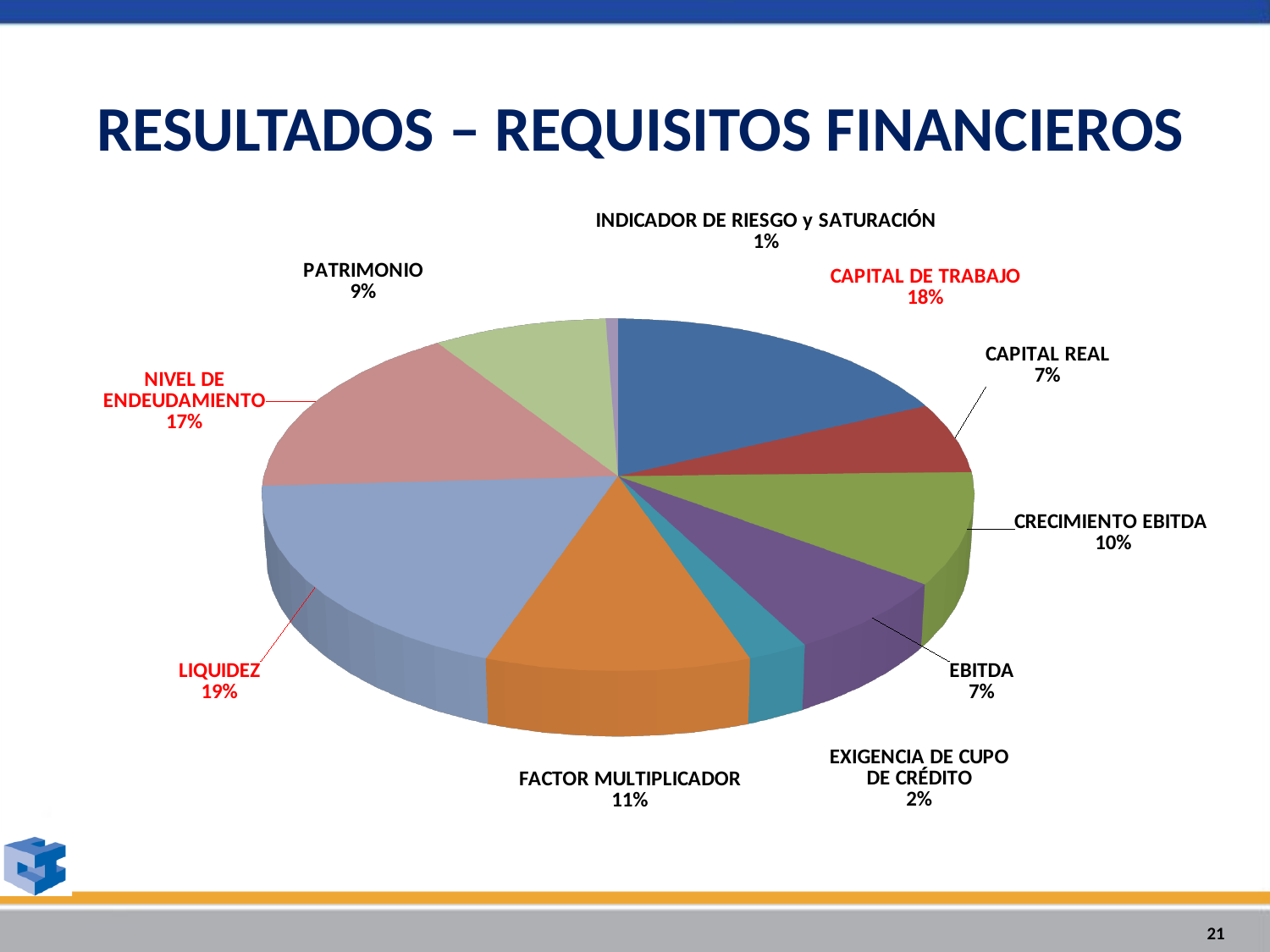
What is the value shown for CAPITAL DE TRABAJO? 18% What is the title of the slide containing the chart? RESULTADOS – REQUISITOS FINANCIEROS What is the combined share of CAPITAL REAL and EBITDA? 14% What percentage is shown for FACTOR MULTIPLICADOR? 11% Which is larger, CRECIMIENTO EBITDA or PATRIMONIO? CRECIMIENTO EBITDA Which category has the largest share of the pie? LIQUIDEZ How many categories (slices) does the pie chart have? 10 What is the difference in percentage points between LIQUIDEZ and NIVEL DE ENDEUDAMIENTO? 2 Which category has the smallest share of the pie? INDICADOR DE RIESGO y SATURACIÓN What is the value for EXIGENCIA DE CUPO DE CRÉDITO? 2% What percentage does the LIQUIDEZ slice represent? 19% What kind of chart is shown on the slide? Pie chart